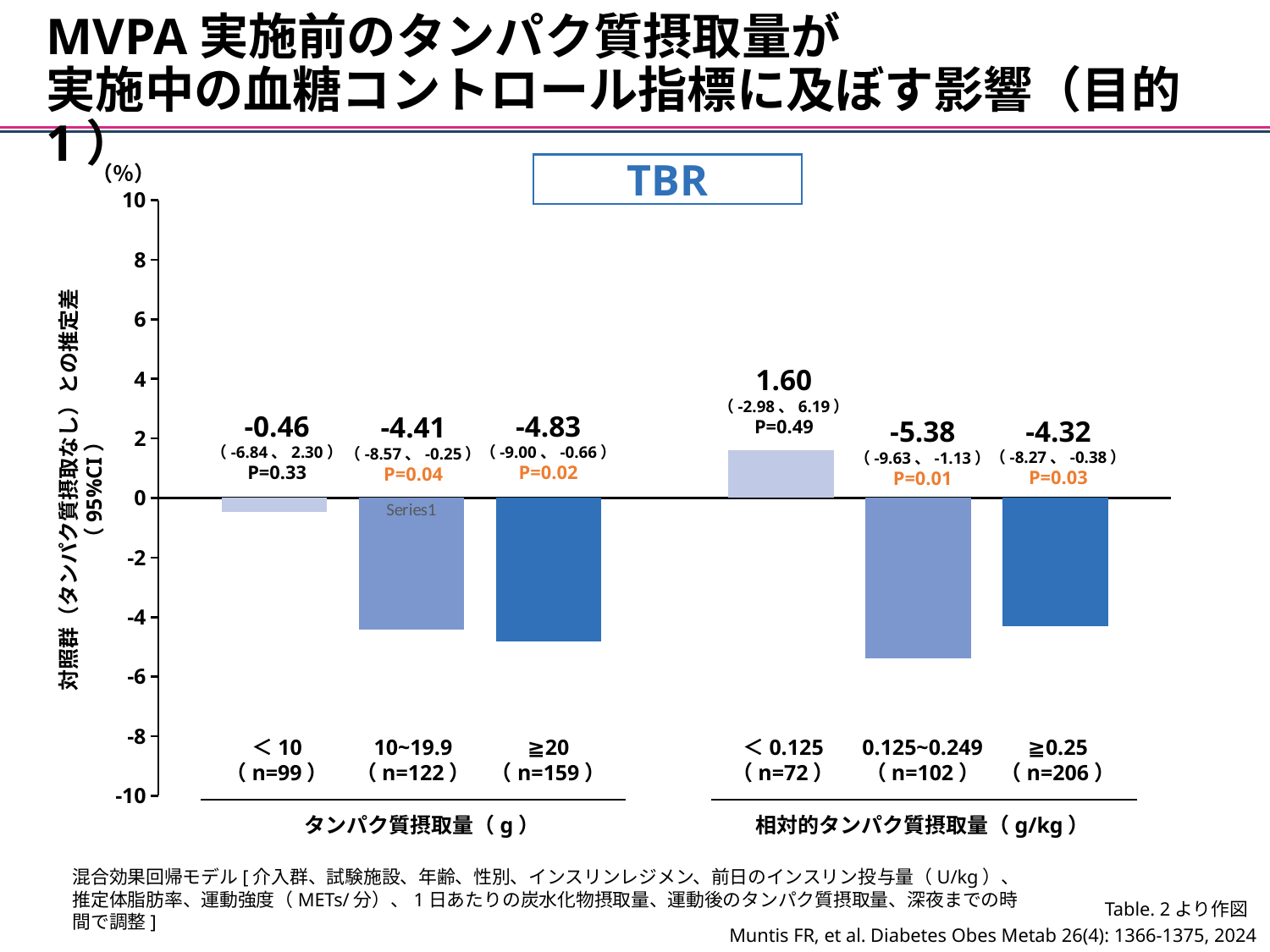
What kind of chart is shown on the slide? bar chart How many categories are plotted in the chart? 6 What is the difference between the estimated differences for ≧20 g (n=159) and 10~19.9 g (n=122)? 0.42 What is the estimated difference for the relative protein intake category <0.125 g/kg (n=72)? 1.60 What is the estimated difference for the protein intake category 10~19.9 g (n=122)? -4.41 What is the estimated difference for the protein intake category <10 g (n=99)? -0.46 Which category has the highest estimated difference? <0.125 (n=72) Which has the larger estimated difference, ≧20 g (n=159) or ≧0.25 g/kg (n=206)? ≧0.25 (n=206) Is the value for 0.125~0.249 g/kg (n=102) greater or less than -4? less What is the P value shown for the ≧0.25 g/kg (n=206) category? P=0.03 Which category has the lowest estimated difference? 0.125~0.249 (n=102) What is the estimated difference for the relative protein intake category 0.125~0.249 g/kg (n=102)? -5.38